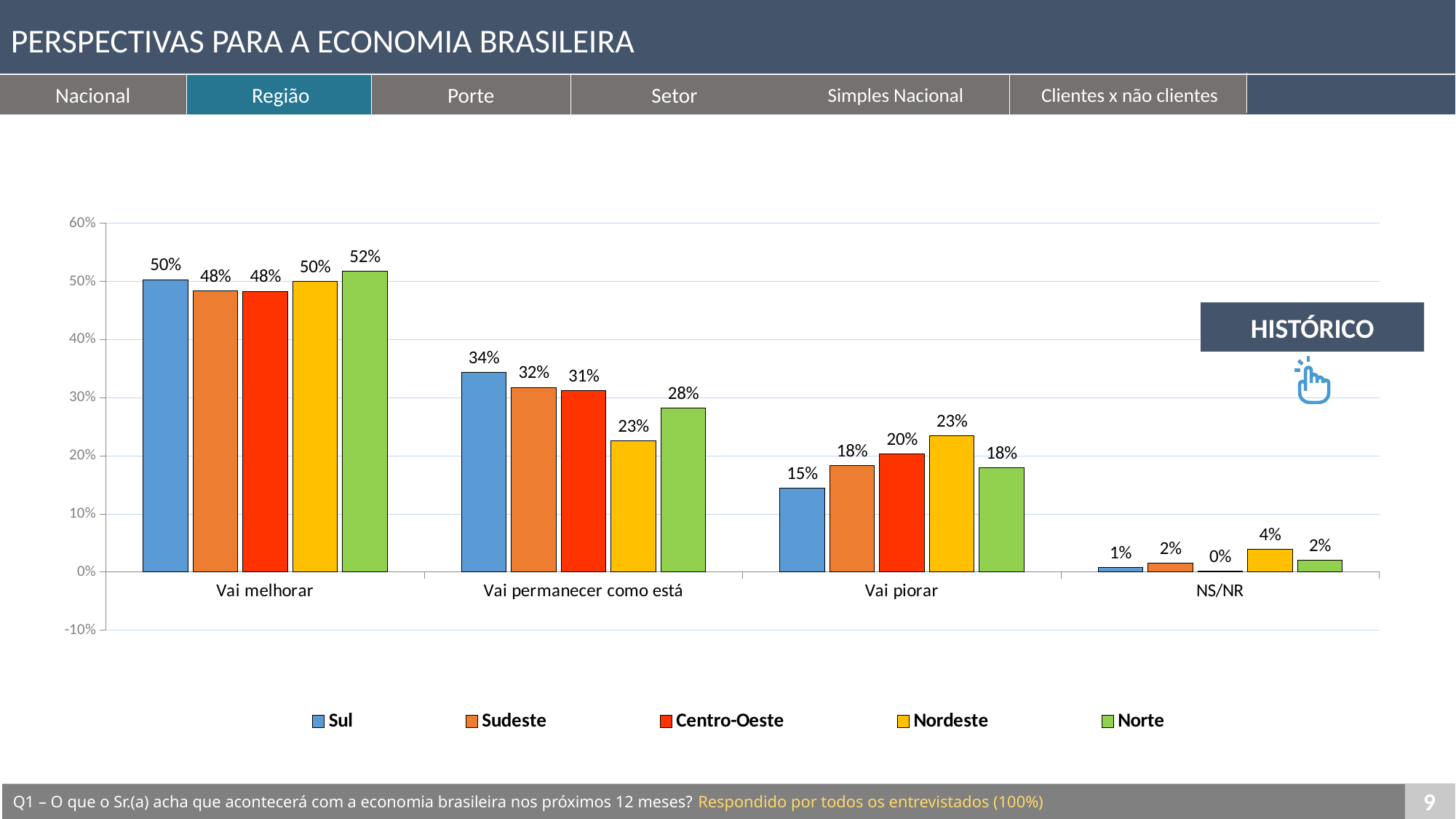
What is the value for Nordeste in the "Vai piorar" category? 23% Which region has the lowest value in the "Vai piorar" category? Sul What is the value for Centro-Oeste in the "NS/NR" category? 0% What is the difference between Sul and Nordeste in the "Vai permanecer como está" category? 11 percentage points What kind of chart is shown on the slide? Bar chart What is the value for Sul in the "Vai permanecer como está" category? 34% In the "Vai piorar" category, which is larger: the value for Centro-Oeste or the value for Sudeste? Centro-Oeste How many series does the legend list? 5 Which region has the highest value in the "Vai melhorar" category? Norte How many categories are shown on the x axis? 4 What is the value for Norte in the "Vai melhorar" category? 52% Which colour represents the Nordeste series in the legend? Yellow